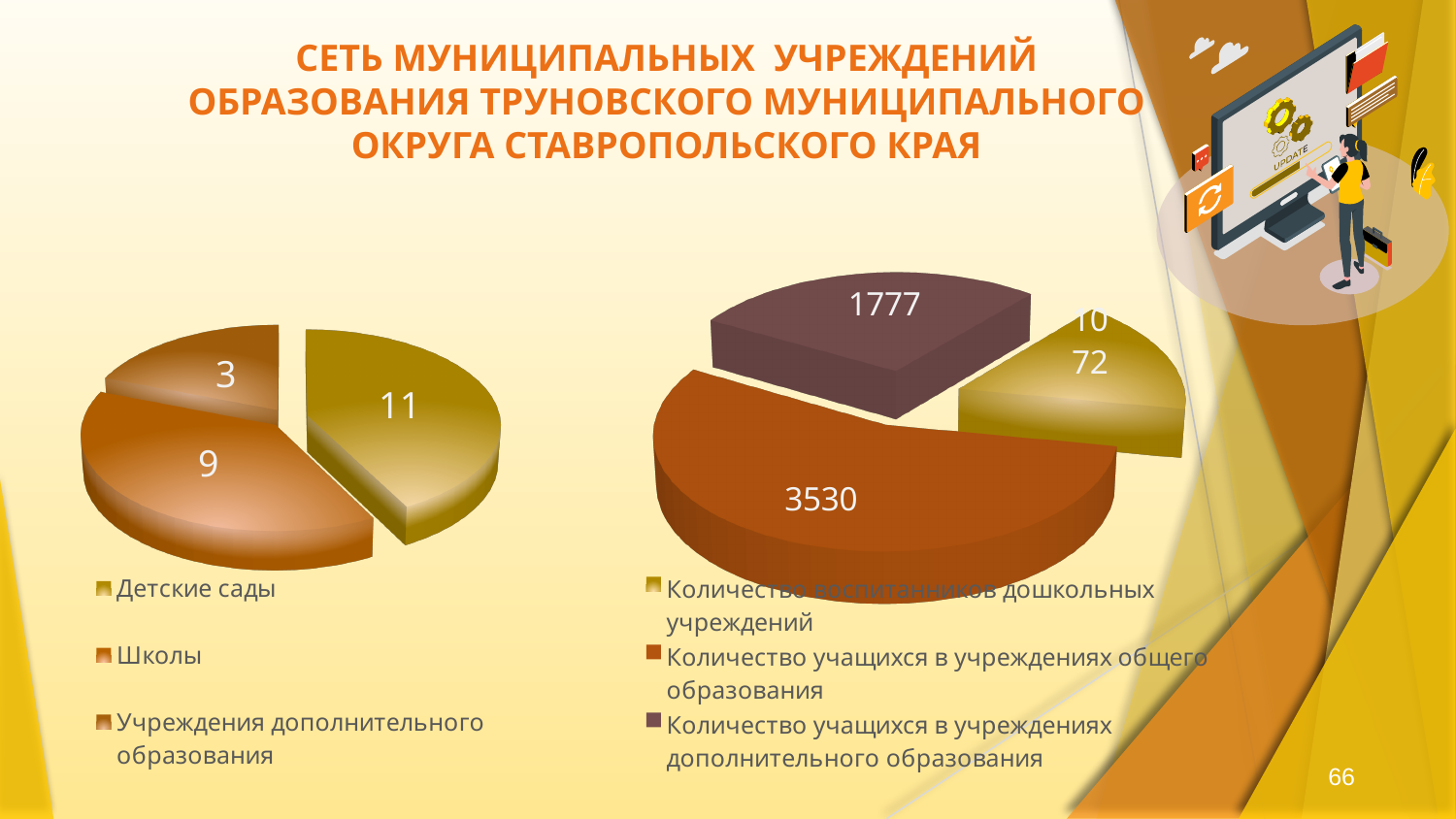
On the right pie chart, what is the value for Количество учащихся в учреждениях общего образования? 3530 On the left pie chart, how many categories are shown? 3 On the right pie chart, which category has the largest value? Количество учащихся в учреждениях общего образования On the left pie chart, what is the value for Учреждения дополнительного образования? 3 On the right pie chart, what is the value for Количество учащихся в учреждениях дополнительного образования? 1777 On the left pie chart, what is the value for Школы? 9 On the right pie chart, what is the difference between the values for Количество учащихся в учреждениях общего образования and Количество учащихся в учреждениях дополнительного образования? 1753 On the left pie chart, which category has the smallest value? Учреждения дополнительного образования What type of chart is the left chart on the slide? Pie chart On the left pie chart, what is the value for Детские сады? 11 On the left pie chart, which category has the largest value? Детские сады On the left pie chart, what is the difference between the values for Детские сады and Школы? 2